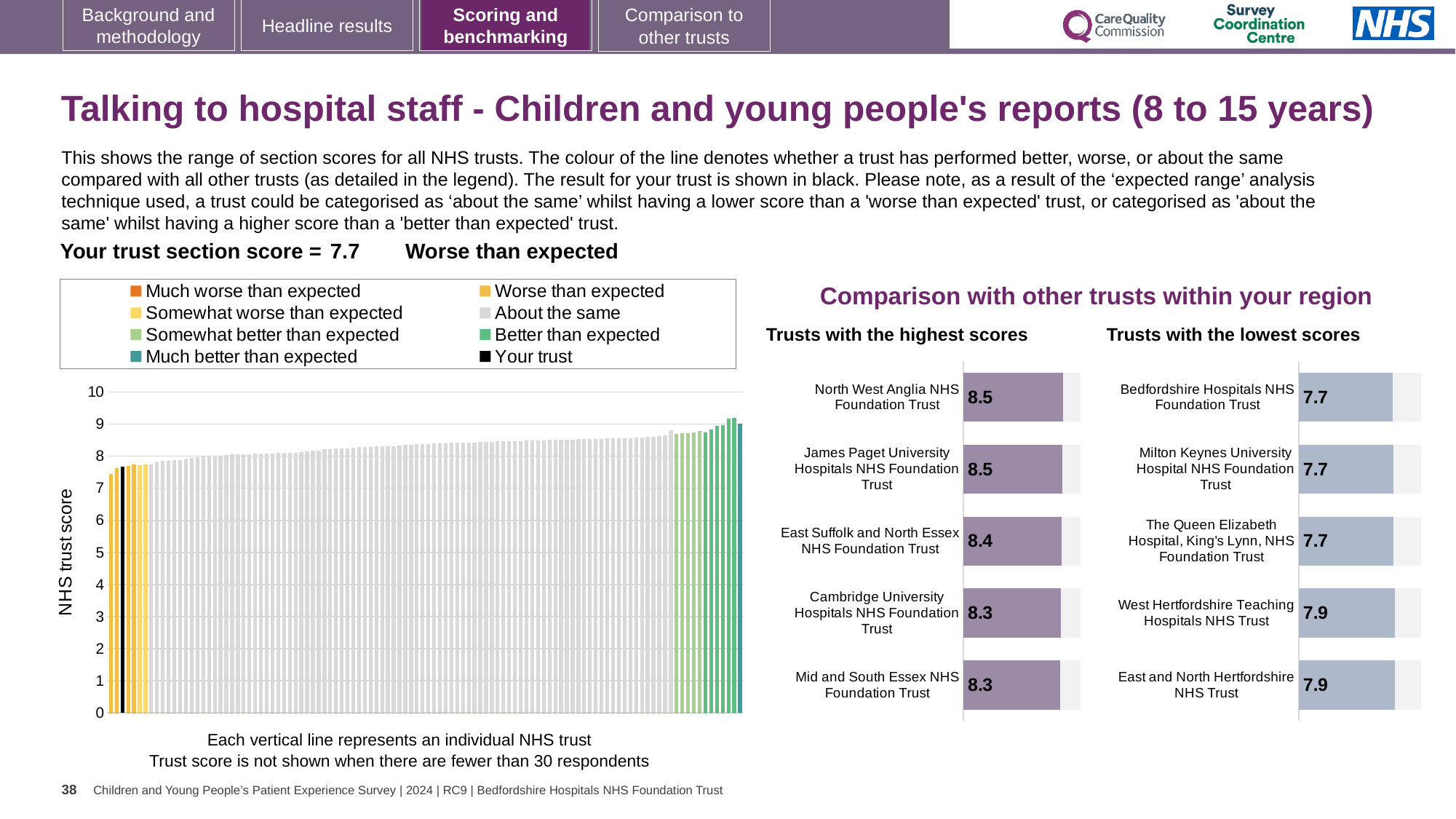
In the large chart on the left, do the bar values rise or fall from left to right along the x axis? rise In the 'Trusts with the lowest scores' chart, what is the score for Bedfordshire Hospitals NHS Foundation Trust? 7.7 In the 'Trusts with the highest scores' chart, what is the difference between the score for North West Anglia NHS Foundation Trust and the score for Mid and South Essex NHS Foundation Trust? 0.2 In the 'Trusts with the highest scores' chart, which has the higher score: East Suffolk and North Essex NHS Foundation Trust or Cambridge University Hospitals NHS Foundation Trust? East Suffolk and North Essex NHS Foundation Trust How many entries does the legend above the large chart on the left list? 8 In the large chart on the left, what is the label on the vertical axis? NHS trust score In the 'Trusts with the highest scores' chart, what is the score for East Suffolk and North Essex NHS Foundation Trust? 8.4 In the 'Trusts with the highest scores' chart, how many trusts are shown? 5 In the large chart on the left, is the value for the black bar (Your trust) greater or less than 8? less In the 'Trusts with the lowest scores' chart, what is the score for West Hertfordshire Teaching Hospitals NHS Trust? 7.9 In the 'Trusts with the lowest scores' chart, what is the difference between the score for East and North Hertfordshire NHS Trust and the score for Milton Keynes University Hospital NHS Foundation Trust? 0.2 What kind of chart is the large chart on the left showing NHS trust scores? bar chart